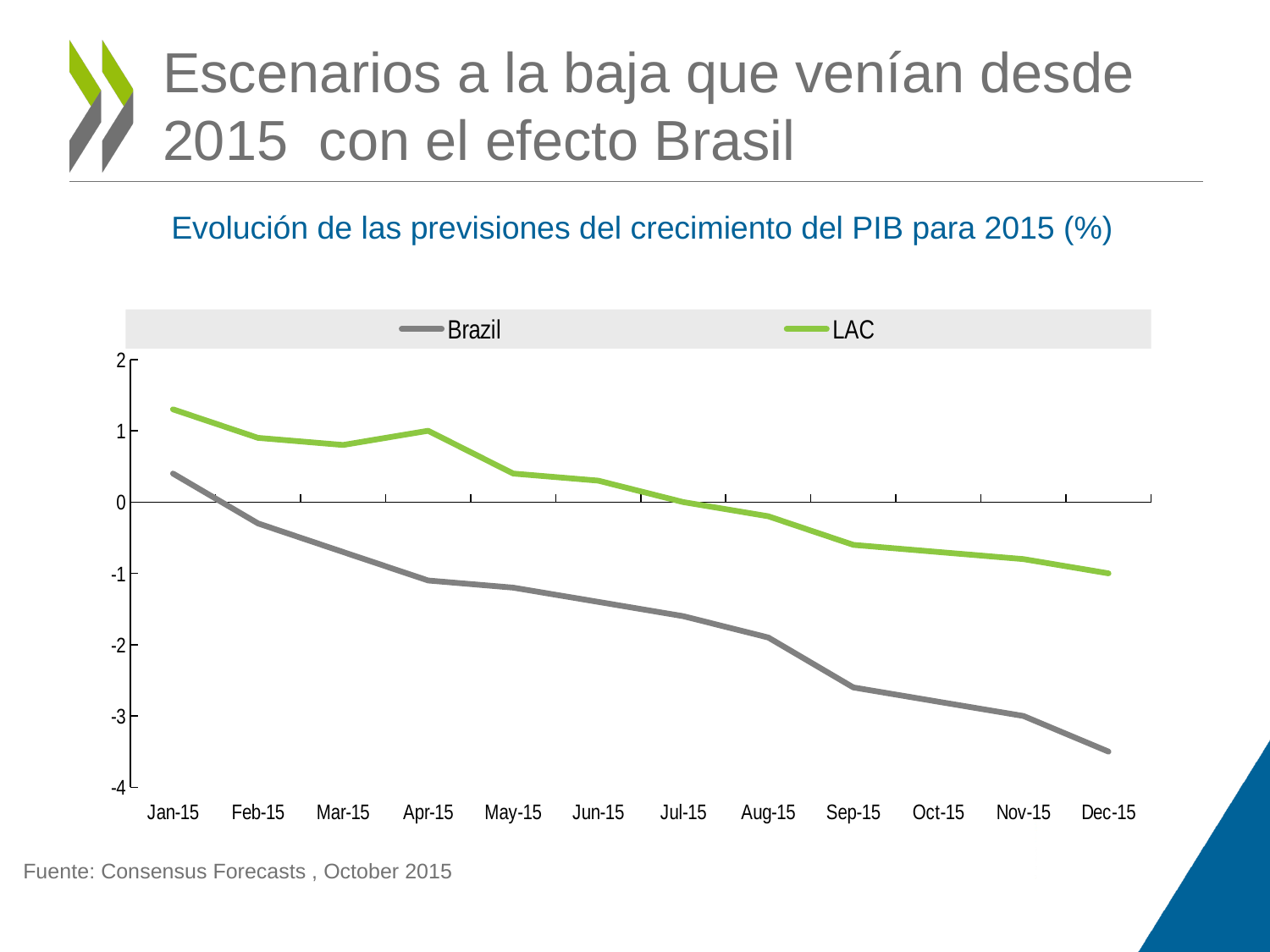
Do the LAC forecasts rise or fall from Jan-15 to Dec-15? fall What is the title of the chart? Evolución de las previsiones del crecimiento del PIB para 2015 (%) Which series has the higher value in Jan-15, Brazil or LAC? LAC In which month is the Brazil forecast lowest? Dec-15 Is the value for LAC in Jan-15 greater or less than 1? greater Do the Brazil forecasts rise or fall from Jan-15 to Dec-15? fall Is the value for Brazil in Dec-15 greater or less than -3? less Is the value for Brazil in Aug-15 greater or less than -1? less What kind of chart is shown on the slide? line chart In which month is the LAC forecast highest? Jan-15 How many months are plotted along the x axis? 12 How many series does the legend list? 2